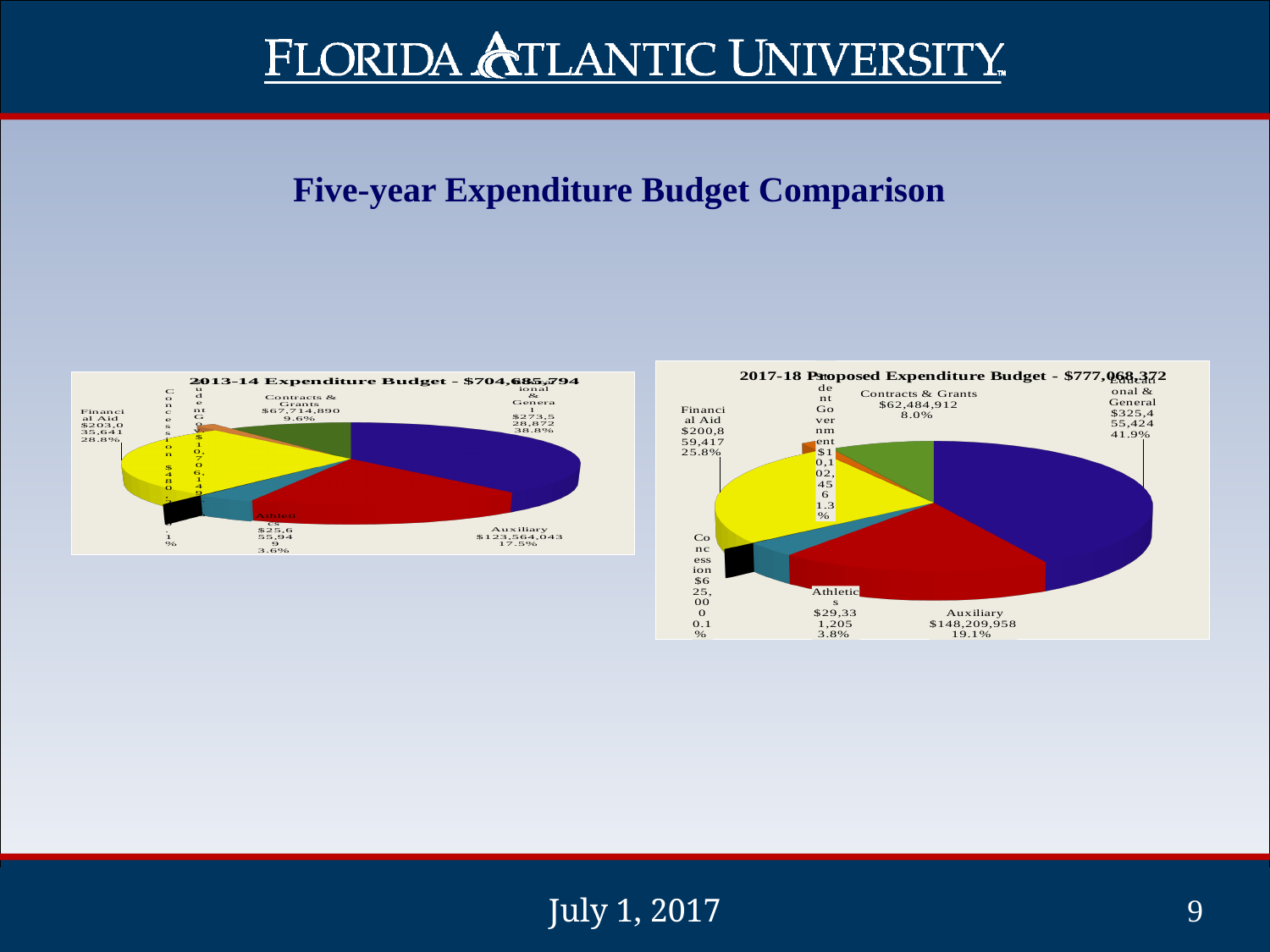
What is the difference between the Auxiliary value in the 2017-18 Proposed Expenditure Budget chart and the Auxiliary value in the 2013-14 Expenditure Budget chart? $24,645,915 What total budget is shown in the title of the 2013-14 Expenditure Budget chart? $704,685,794 In the 2017-18 Proposed Expenditure Budget chart, which is larger, Auxiliary or Financial Aid? Financial Aid In the 2013-14 Expenditure Budget chart, which category has the largest slice? Educational & General What kind of chart is the 2013-14 Expenditure Budget chart? pie chart In the 2013-14 Expenditure Budget chart, what share of the pie is Contracts & Grants? 9.6% How many slices does the 2017-18 Proposed Expenditure Budget pie chart have? 7 What total budget is shown in the title of the 2017-18 Proposed Expenditure Budget chart? $777,068,372 In the 2013-14 Expenditure Budget chart, what is the value for Auxiliary? $123,564,043 In the 2017-18 Proposed Expenditure Budget chart, what share of the pie is Educational & General? 41.9% In the 2017-18 Proposed Expenditure Budget chart, what is the value for Contracts & Grants? $62,484,912 In the 2017-18 Proposed Expenditure Budget chart, which category has the largest slice? Educational & General